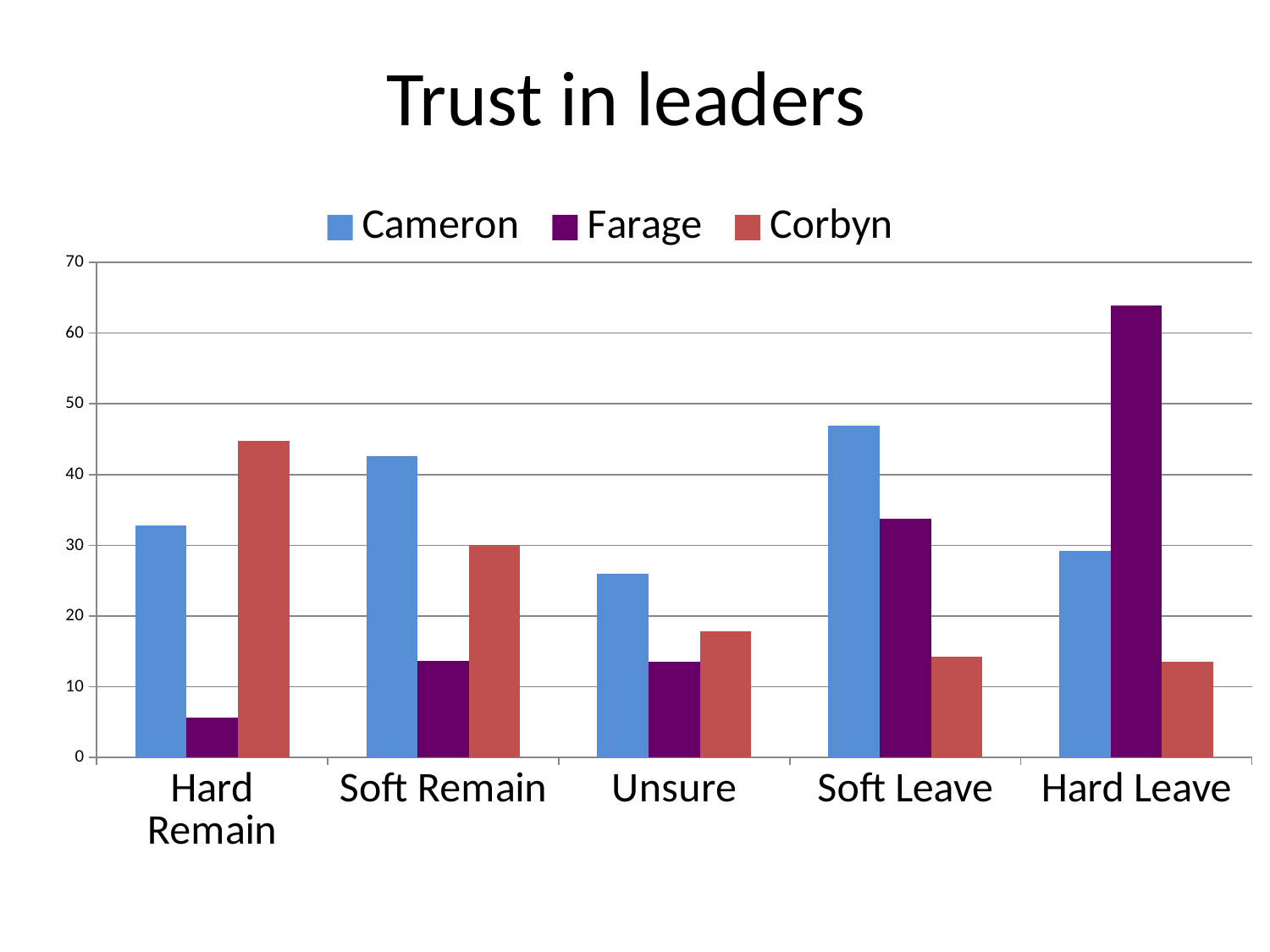
Is the value for Corbyn in the Hard Remain category greater or less than 40? greater Is the value for Farage in the Hard Leave category greater or less than 60? greater Which category has the highest value for Cameron? Soft Leave Which category has the lowest value for Farage? Hard Remain In the Hard Remain category, which is larger: Cameron or Corbyn? Corbyn What kind of chart is shown on the slide? bar chart Which category has the highest value for Corbyn? Hard Remain How many categories are shown on the x axis? 5 What is the title of the chart? Trust in leaders How many series does the legend list? 3 Do the values for Corbyn rise or fall moving from Hard Remain to Hard Leave along the x axis? fall Which category has the highest value for Farage? Hard Leave